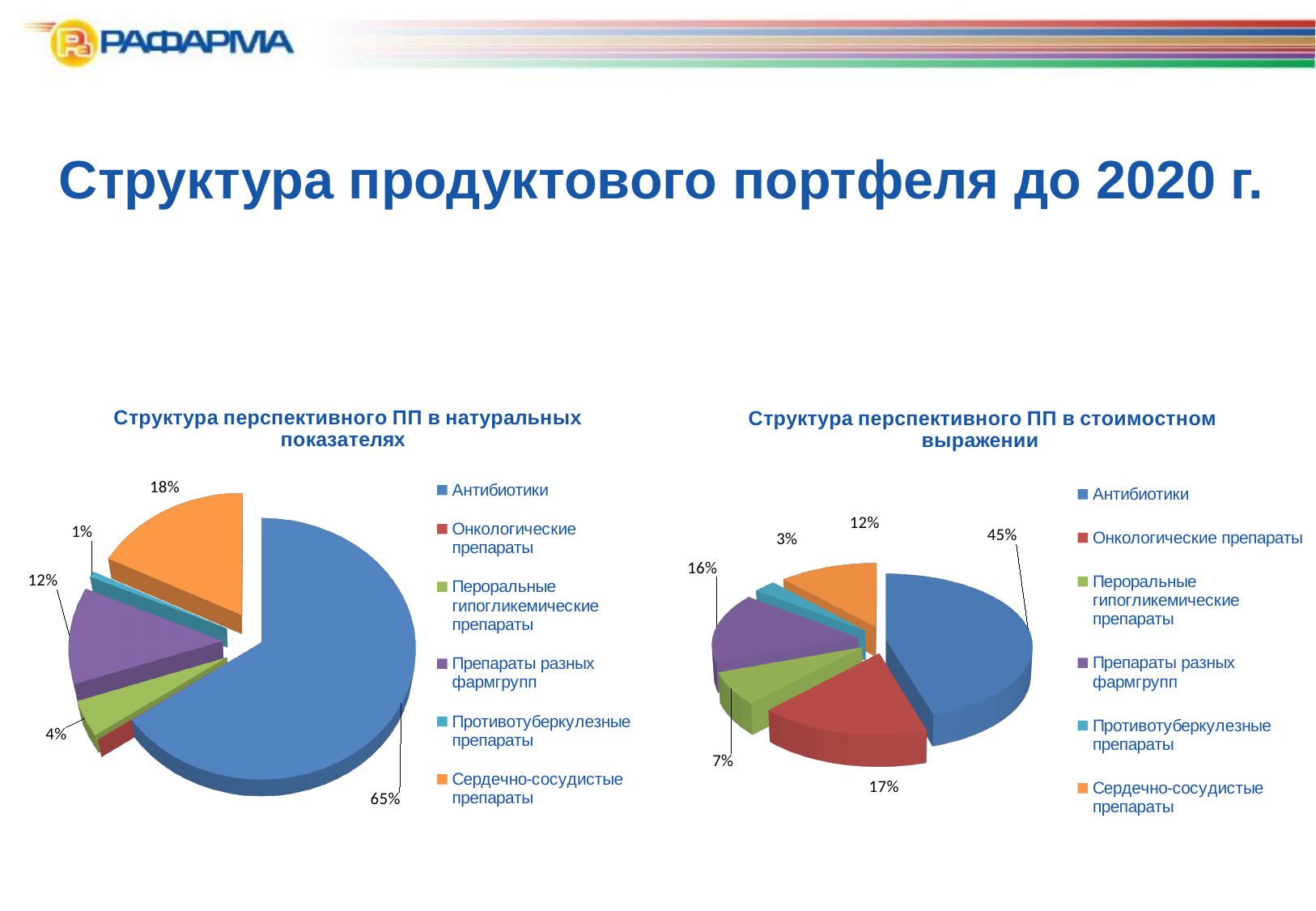
On the right chart (Структура перспективного ПП в стоимостном выражении), what colour is the slice for Сердечно-сосудистые препараты? Orange On the left chart (Структура перспективного ПП в натуральных показателях), what share do Сердечно-сосудистые препараты have? 18% On the right chart (Структура перспективного ПП в стоимостном выражении), what share do Препараты разных фармгрупп have? 16% On the left chart (Структура перспективного ПП в натуральных показателях), which is larger: the share of Препараты разных фармгрупп or the share of Пероральные гипогликемические препараты? Препараты разных фармгрупп On the right chart (Структура перспективного ПП в стоимостном выражении), what share do Онкологические препараты have? 17% On the left chart (Структура перспективного ПП в натуральных показателях), what share do Противотуберкулезные препараты have? 1% On the right chart (Структура перспективного ПП в стоимостном выражении), which category has the smallest share? Противотуберкулезные препараты How many categories does the legend of the left chart (Структура перспективного ПП в натуральных показателях) list? 6 On the left chart (Структура перспективного ПП в натуральных показателях), what share do Антибиотики have? 65% What type of chart is the right chart (Структура перспективного ПП в стоимостном выражении)? Pie chart On the right chart (Структура перспективного ПП в стоимостном выражении), what is the difference between the shares of Антибиотики and Онкологические препараты? 28% On the right chart (Структура перспективного ПП в стоимостном выражении), which category has the largest share? Антибиотики